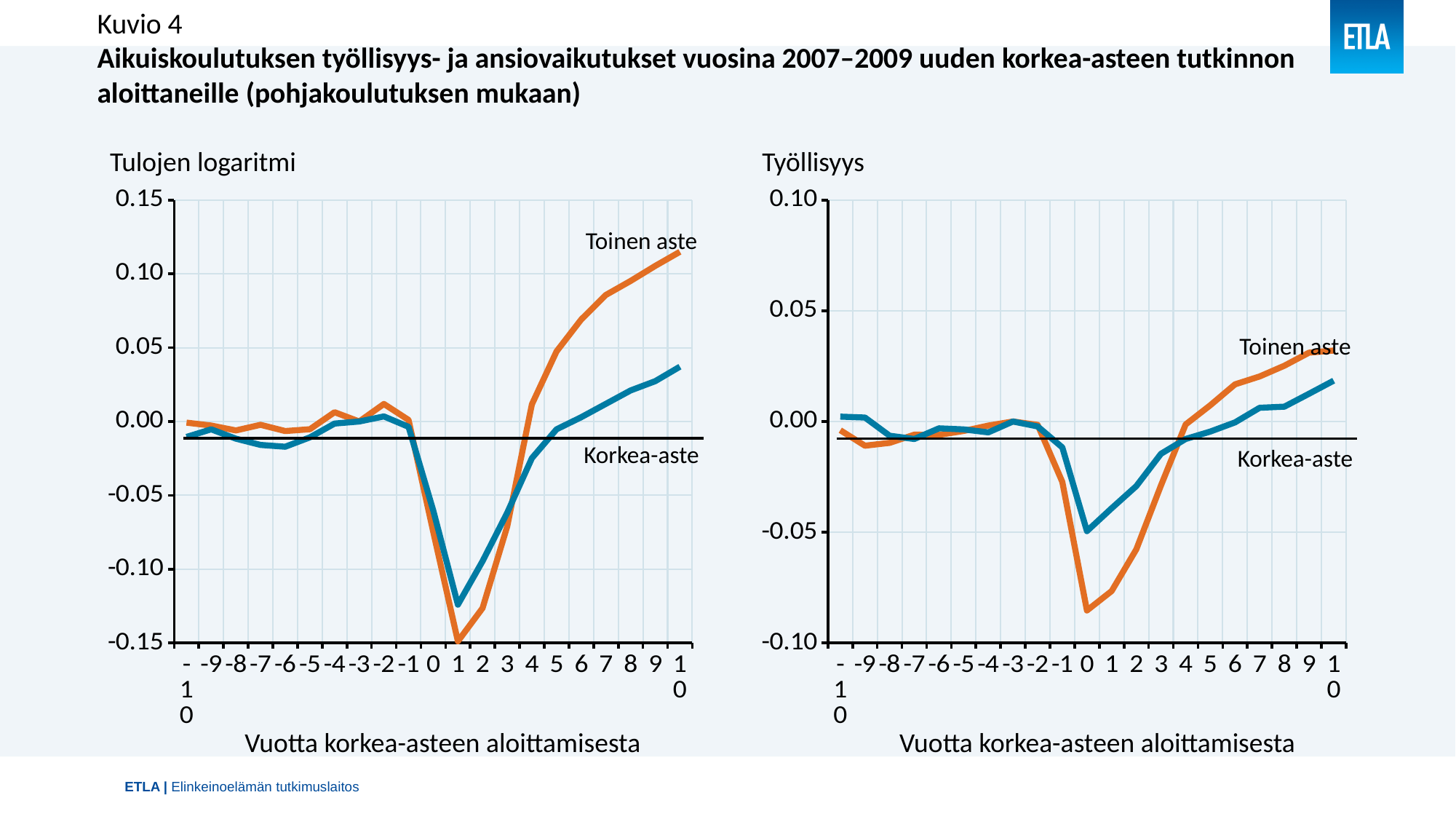
What is the x-axis label of the 'Työllisyys' chart? Vuotta korkea-asteen aloittamisesta On the 'Työllisyys' chart, is the value for Korkea-aste at year 10 greater or less than 0.05? less On the 'Tulojen logaritmi' chart, is the value for Korkea-aste at year 1 greater or less than -0.10? less What kind of chart is the 'Tulojen logaritmi' chart? line chart On the 'Tulojen logaritmi' chart, does the Toinen aste line rise or fall from year 1 to year 10? rise On the 'Tulojen logaritmi' chart, which series has the higher value at year 10, Toinen aste or Korkea-aste? Toinen aste On the 'Tulojen logaritmi' chart, is the value for Toinen aste at year 10 greater or less than 0.10? greater On the 'Työllisyys' chart, which series has the higher value at year 10, Toinen aste or Korkea-aste? Toinen aste How many series are plotted on the 'Työllisyys' chart? 2 On the 'Työllisyys' chart, which series has the higher value at year 0, Toinen aste or Korkea-aste? Korkea-aste